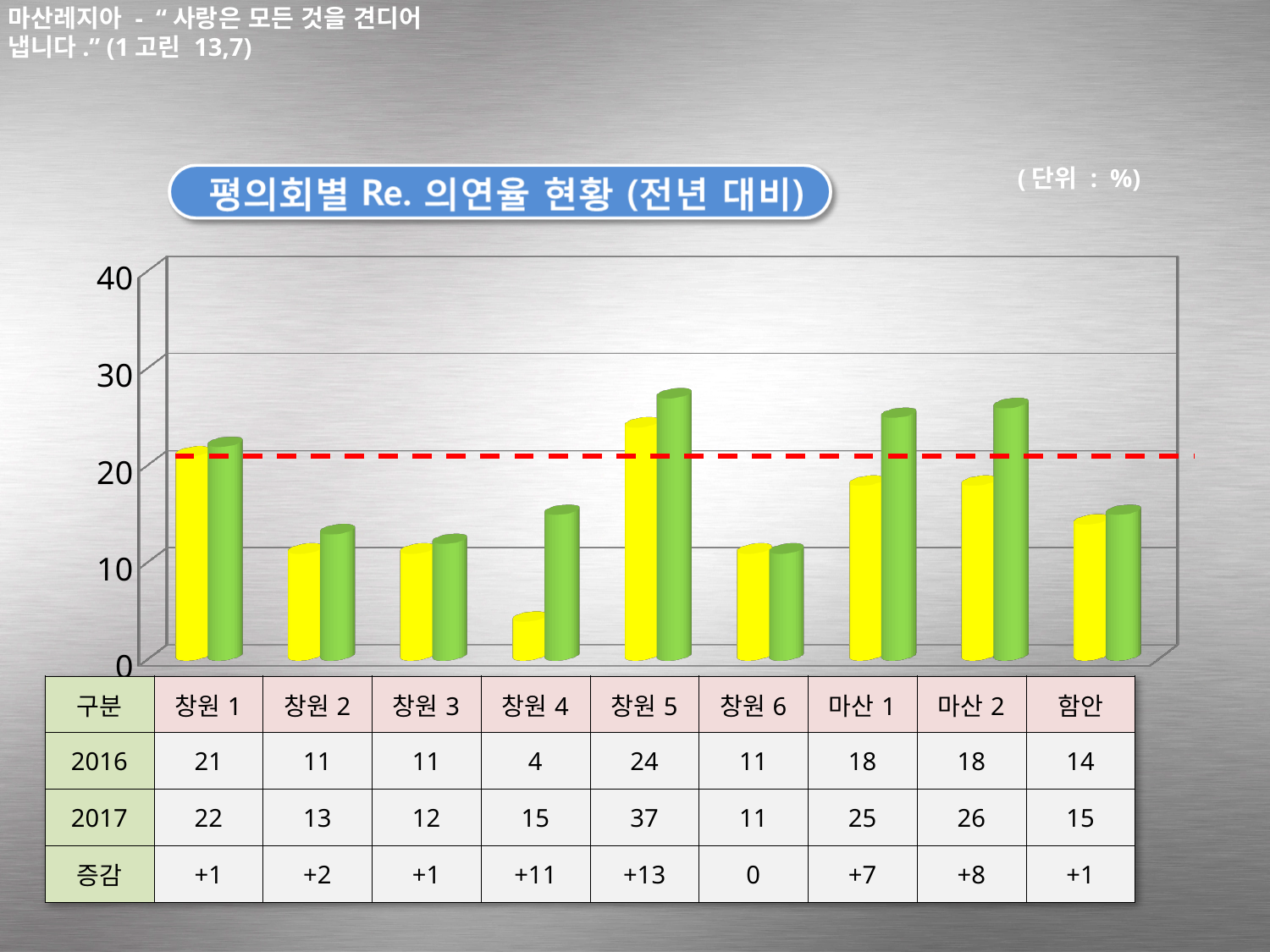
What is the 2017 value for 마산 2? 26 What kind of chart is shown on the slide? bar chart Which category has the highest 2017 value? 창원 5 What unit is indicated for the chart values? % What is the 2016 value for 창원 4? 4 Which has the larger 2017 value, 마산 1 or 마산 2? 마산 2 By how much did 마산 1 increase from 2016 to 2017? 7 What is the 2017 value for 창원 2? 13 Which category has the lowest 2016 value? 창원 4 How many data series (years) are plotted in the chart? 2 How many categories are shown on the x axis? 9 Is the 2017 value for 창원 4 greater or less than 10? greater